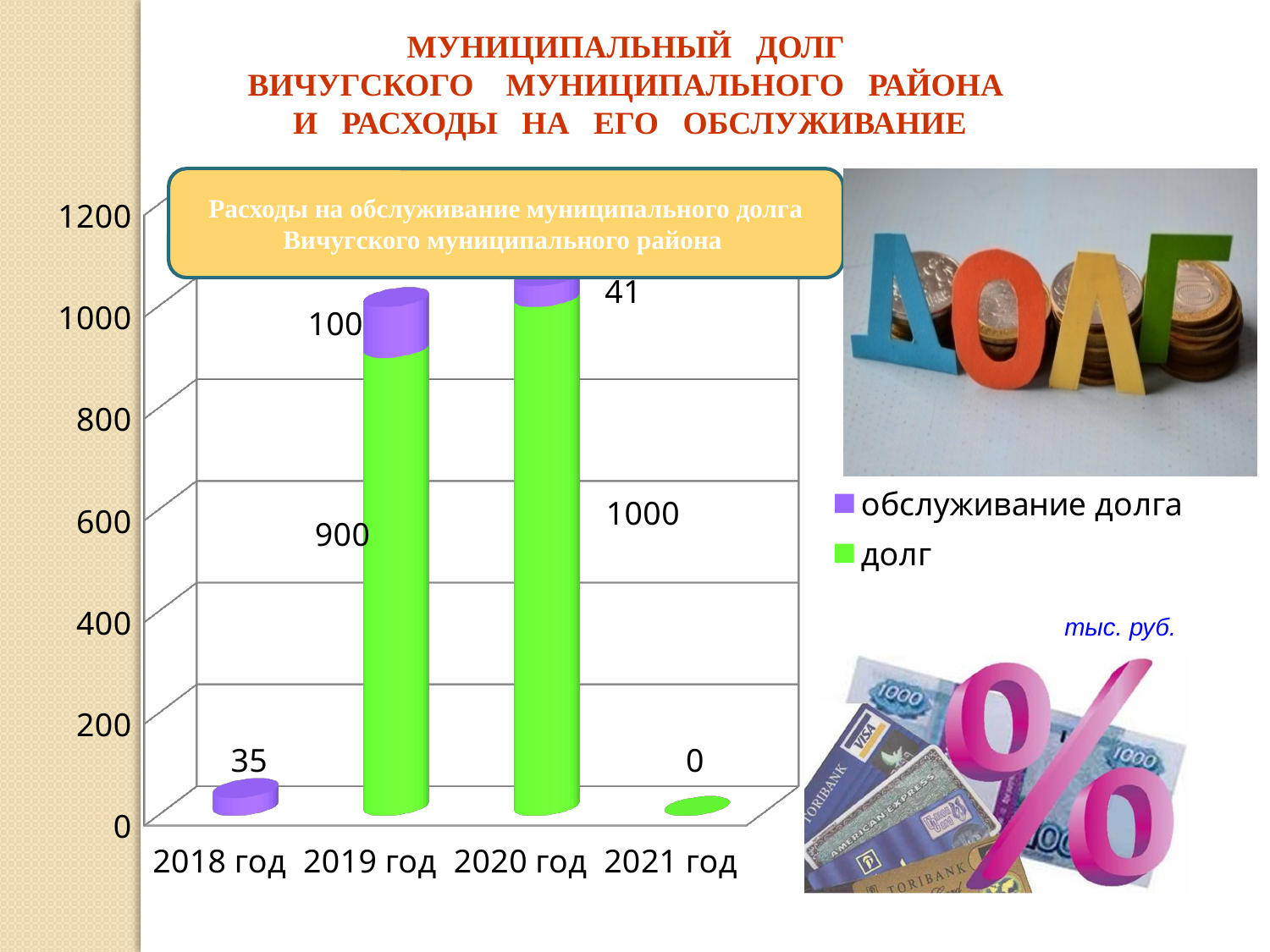
How many series does the legend list? 2 What is the value of обслуживание долга for 2020 год? 41 Which year has the highest value of долг? 2020 год What is the value of обслуживание долга for 2018 год? 35 What is the value of долг for 2021 год? 0 What is the total of the stacked bar for 2019 год? 1000 What is the value of обслуживание долга for 2019 год? 100 What is the value of долг for 2020 год? 1000 What is the value of долг for 2019 год? 900 Which is larger: обслуживание долга in 2019 год or in 2020 год? 2019 год What type of chart is shown on the slide? Stacked bar chart What is the difference between долг in 2020 год and 2019 год? 100